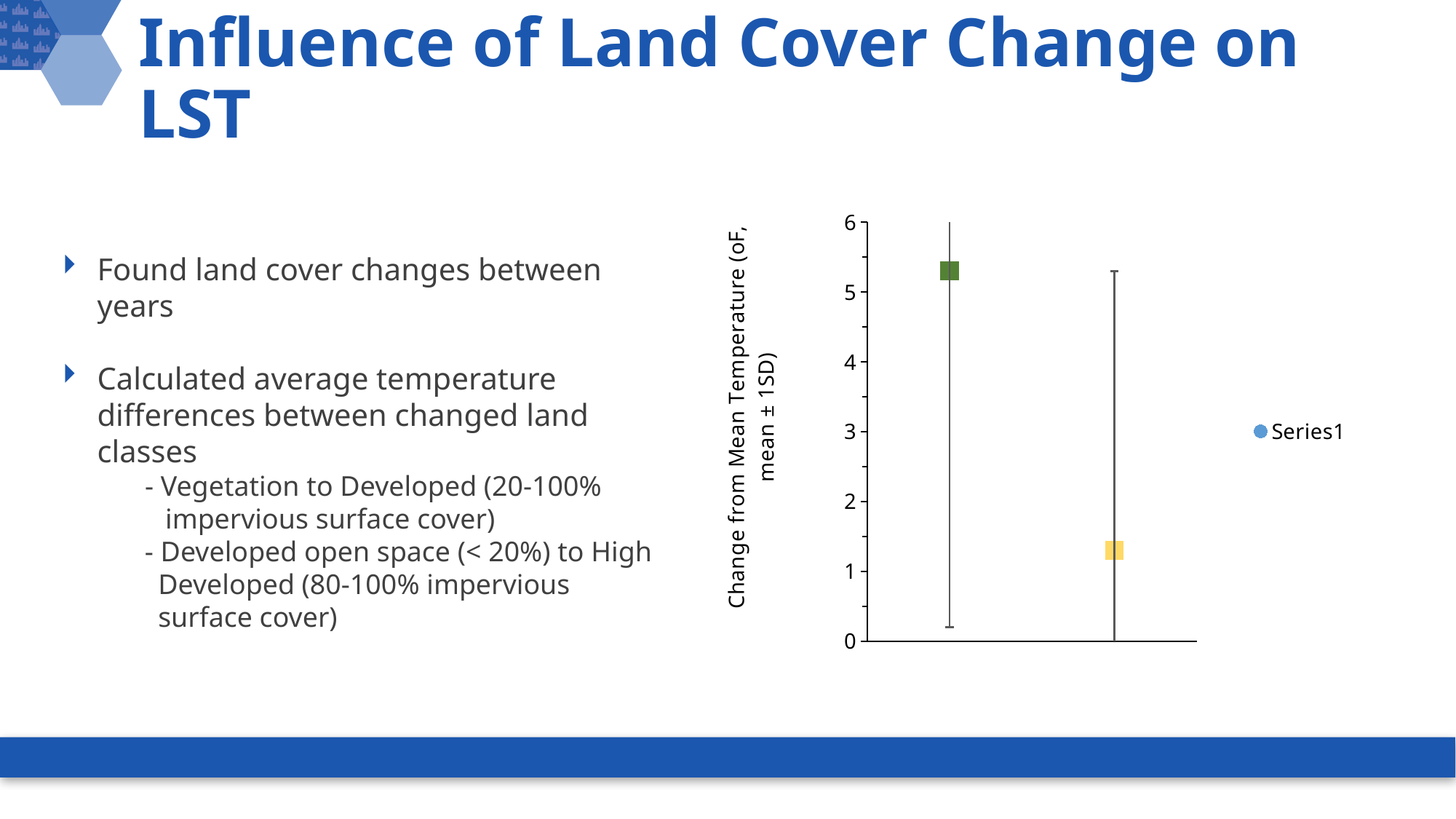
Is the value of the green point greater or less than 5? greater Is the value of the yellow point greater or less than 2? less What is the label on the chart's vertical axis? Change from Mean Temperature (oF, mean ± 1SD) Is the value of the green point greater or less than 6? less How many series does the chart legend list? 1 What is the highest value shown on the chart's vertical axis? 6 How many data points are plotted on the chart? 2 Which point has the higher value, the green point or the yellow point? the green point What is the name of the series shown in the chart legend? Series1